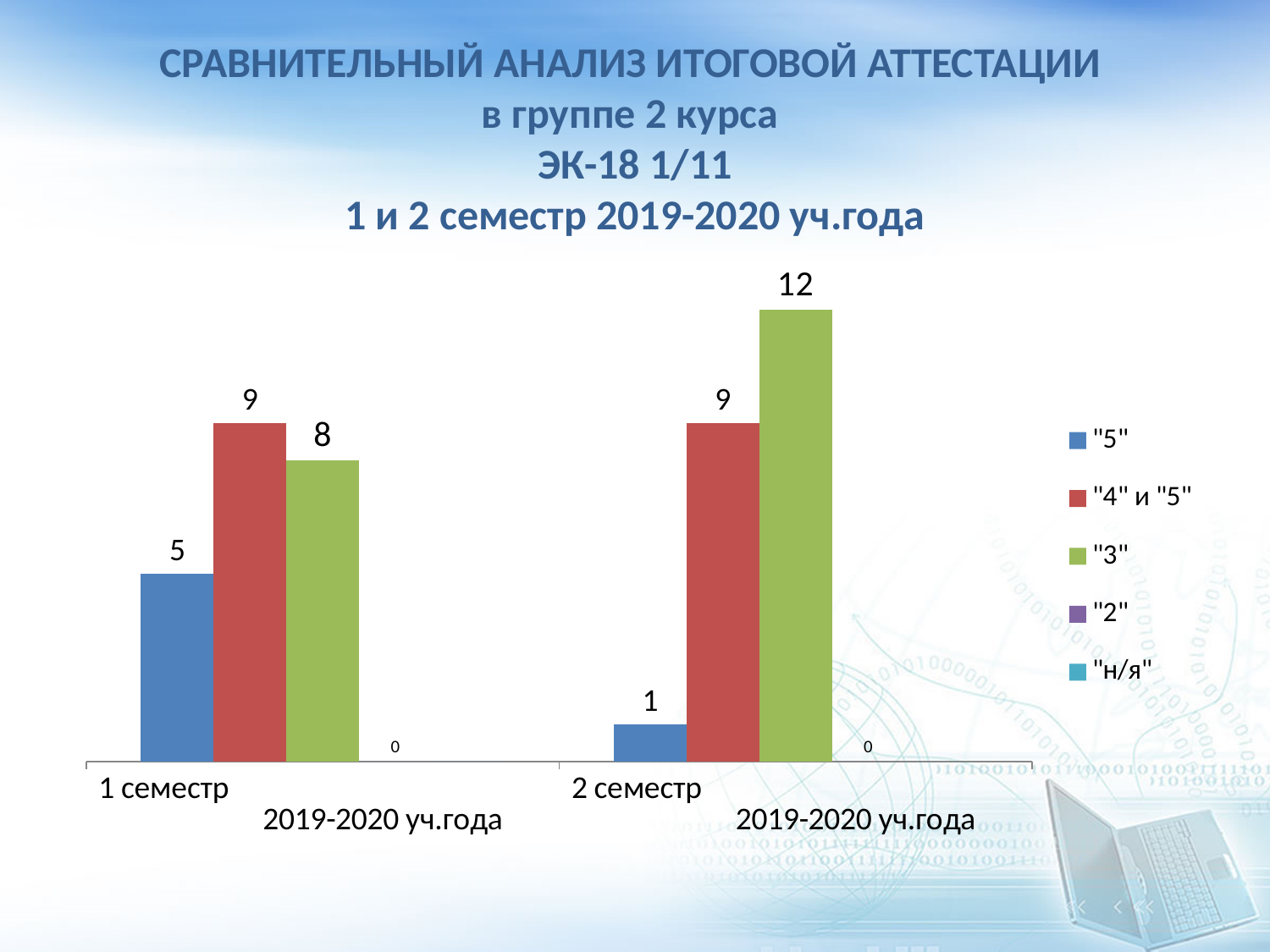
Which series has the highest value in 2 семестр 2019-2020 уч.года? "3" Does the value for "5" rise or fall from 1 семестр to 2 семестр 2019-2020 уч.года? fall Which series has the highest value in 1 семестр 2019-2020 уч.года? "4" и "5" What is the difference between the "3" values in 2 семестр and 1 семестр 2019-2020 уч.года? 4 What is the value for "5" in 1 семестр 2019-2020 уч.года? 5 Which is larger: the "5" value in 1 семестр or in 2 семестр 2019-2020 уч.года? 1 семестр What is the value for "5" in 2 семестр 2019-2020 уч.года? 1 What is the value for "4" и "5" in 1 семестр 2019-2020 уч.года? 9 What kind of chart is shown on the slide? bar chart How many categories are shown on the x axis? 2 How many series does the legend list? 5 What is the value for "3" in 2 семестр 2019-2020 уч.года? 12